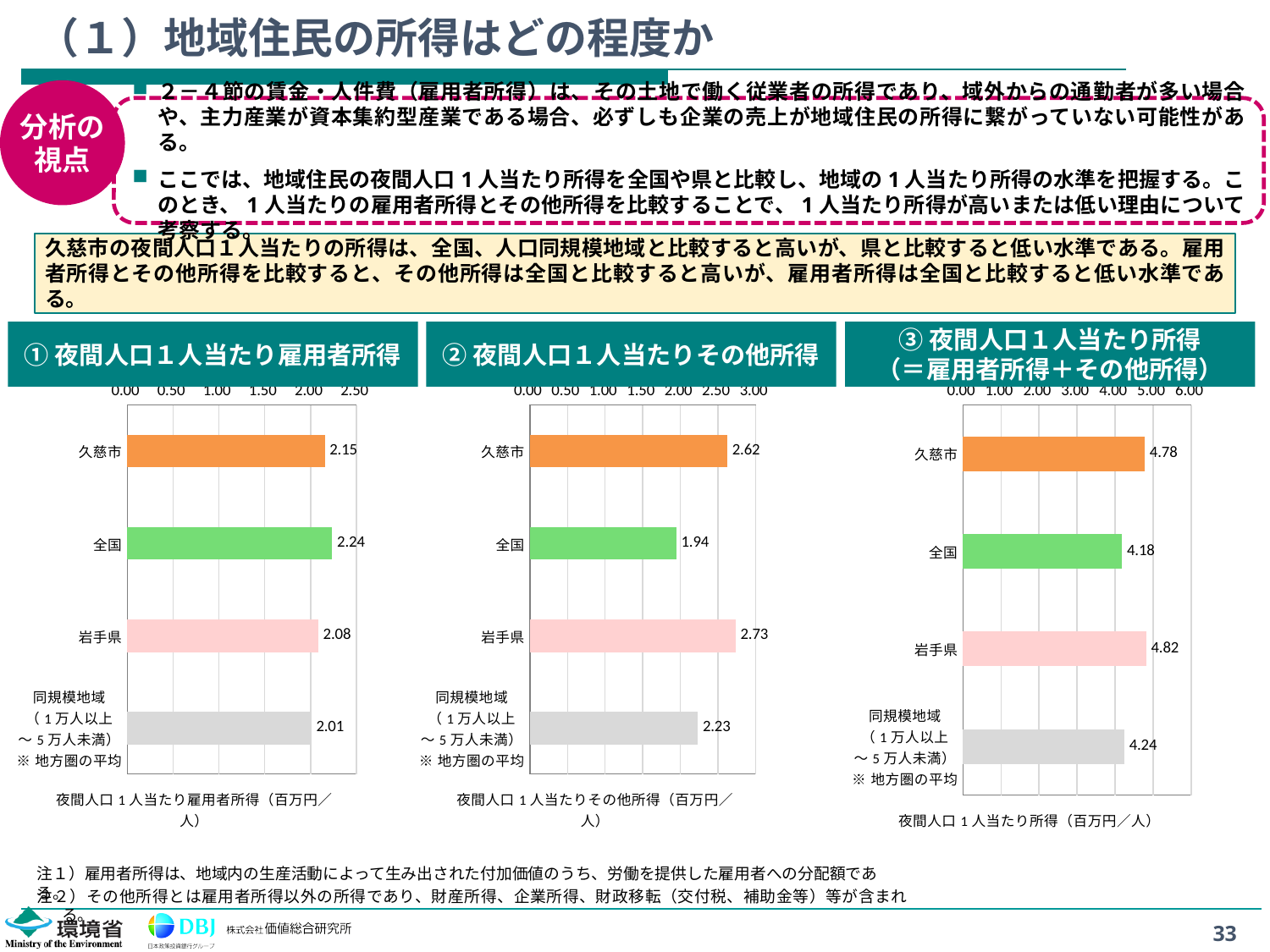
In the chart ③ 夜間人口１人当たり所得, which is larger, 久慈市 or 全国? 久慈市 How many categories are shown in the chart ① 夜間人口１人当たり雇用者所得? 4 In the chart ③ 夜間人口１人当たり所得, is the value for 全国 greater or less than 5.00? less In the chart ① 夜間人口１人当たり雇用者所得, which category has the lowest value? 同規模地域 In the chart ① 夜間人口１人当たり雇用者所得, what is the value for 久慈市? 2.15 In the chart ② 夜間人口１人当たりその他所得, which category has the highest value? 岩手県 In the chart ① 夜間人口１人当たり雇用者所得, which category has the highest value? 全国 In the chart ③ 夜間人口１人当たり所得, what is the difference between 久慈市 and 同規模地域? 0.54 In the chart ② 夜間人口１人当たりその他所得, what is the difference between 久慈市 and 全国? 0.68 In the chart ② 夜間人口１人当たりその他所得, what is the value for 全国? 1.94 What kind of chart is the chart ② 夜間人口１人当たりその他所得? Bar chart In the chart ③ 夜間人口１人当たり所得, what is the value for 岩手県? 4.82